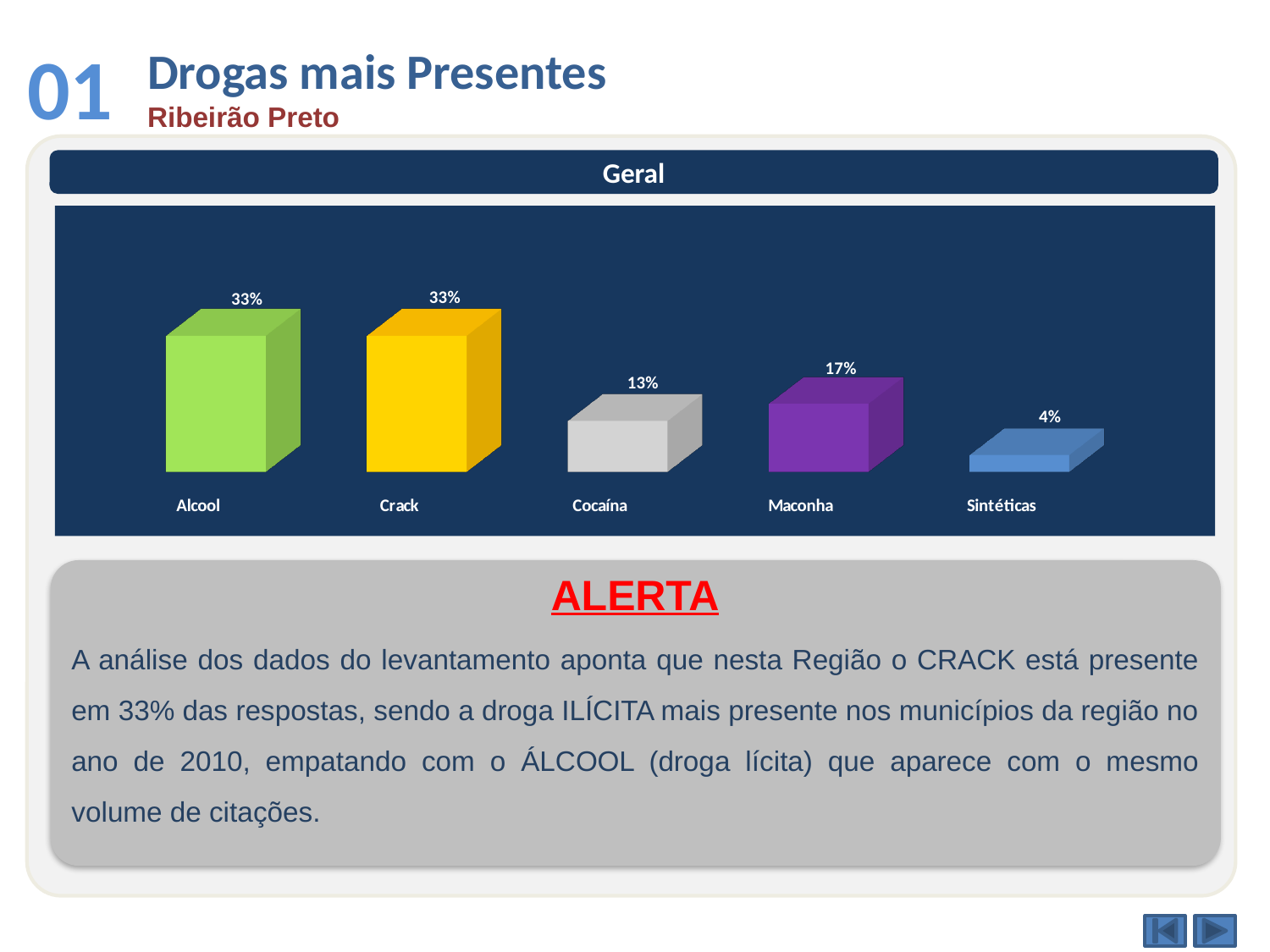
What is the difference between the values for Alcool and Sintéticas? 29% What is the value for Cocaína? 13% Which category has the lowest value? Sintéticas Which is larger, the value for Crack or the value for Sintéticas? Crack What is the value for Crack? 33% What kind of chart is shown on the slide? Bar chart What is the value for Maconha? 17% What is the title shown above the chart? Geral How many categories are shown in the chart? 5 What is the difference between the values for Maconha and Cocaína? 4% What is the value for Sintéticas? 4% Which is larger, the value for Maconha or the value for Cocaína? Maconha